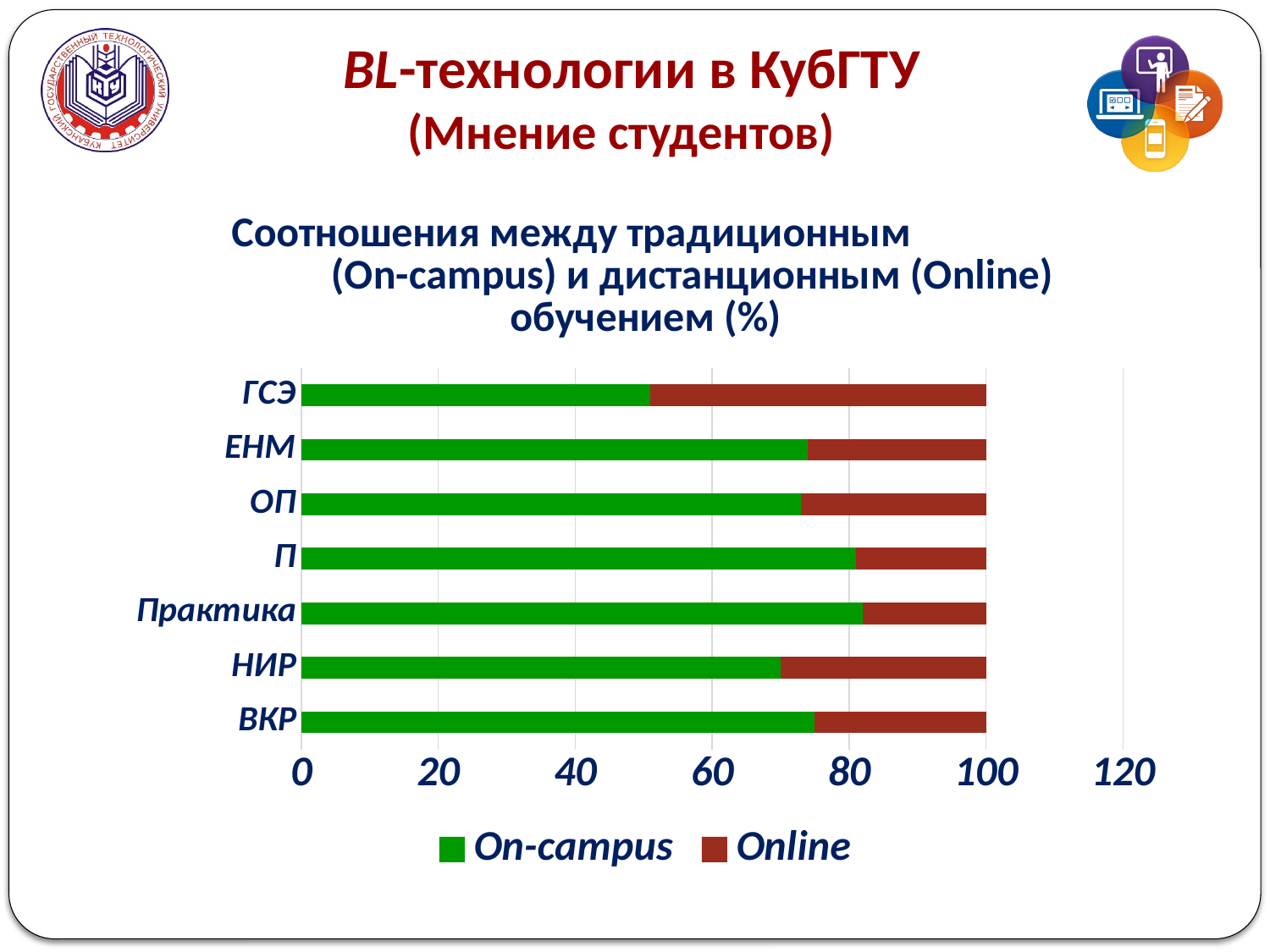
How many categories are plotted on the chart? 7 What is the highest value shown on the horizontal axis? 120 Which is larger, the On-campus value for ГСЭ or for Практика? Практика Which category has the highest Online value? ГСЭ Which series is shown in green in the legend? On-campus Which category has the lowest On-campus value? ГСЭ How many series does the legend list? 2 Is the On-campus value for ГСЭ greater or less than 60? less What is the total of the stacked bar for ГСЭ? 100 Is the On-campus value for НИР greater or less than 60? greater What kind of chart is shown on the slide? Stacked bar chart